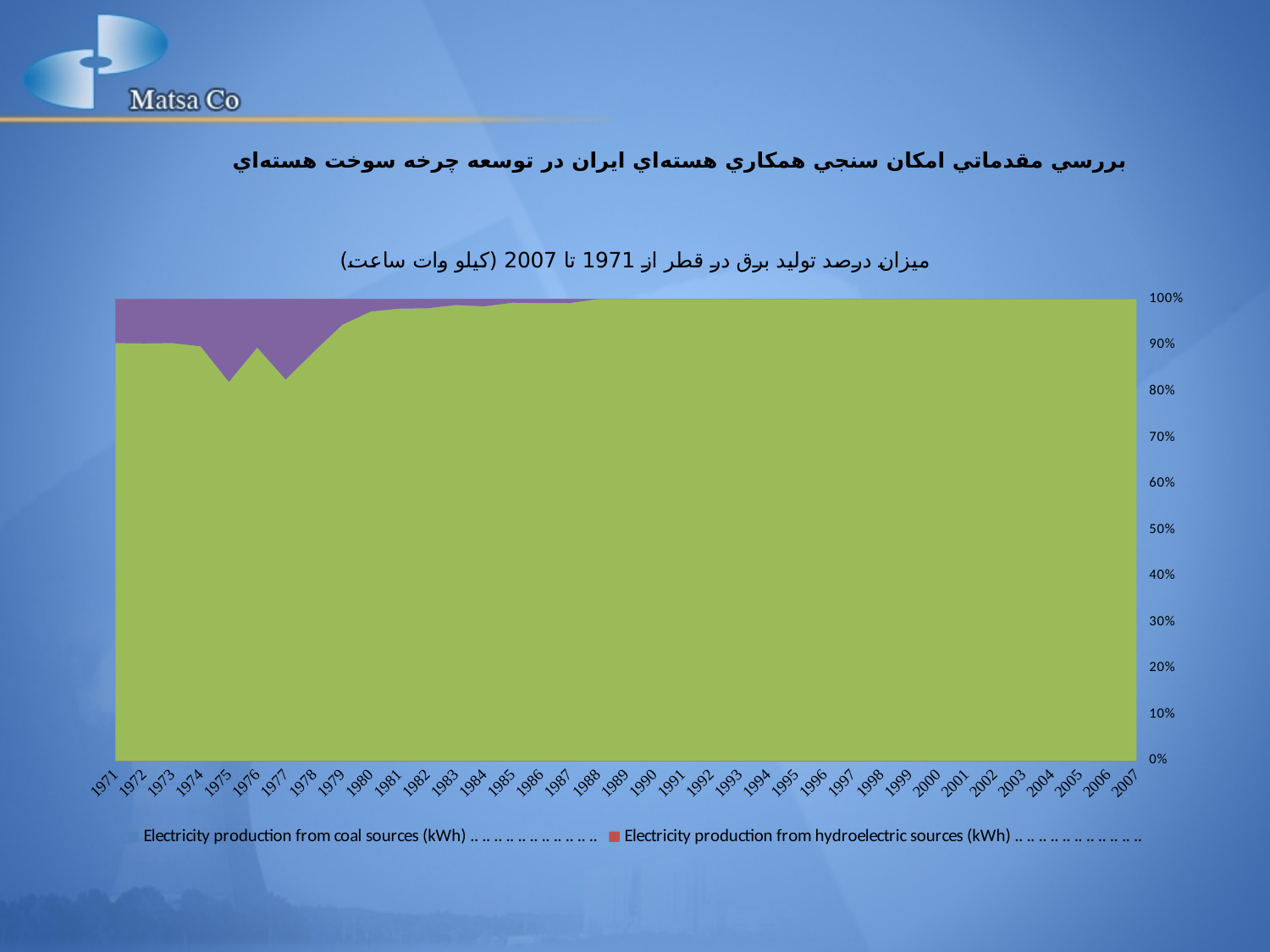
Is the share of the green (lower) area in 1975 greater or less than 90%? less Is the share of the purple (upper) area in 1975 greater or less than 10%? greater How many series does the legend list? 2 Which year has the larger share for the green (lower) area, 1975 or 1985? 1985 In which year does the green (lower) area reach its lowest share? 1975 How many years are plotted along the x axis? 37 Is the share of the purple (upper) area in 2000 greater or less than 10%? less Does the share of the purple (upper) area rise or fall from 1971 to 2007? fall What is the first year shown on the x axis? 1971 What is the last year shown on the x axis? 2007 What kind of chart is shown on the slide? area chart